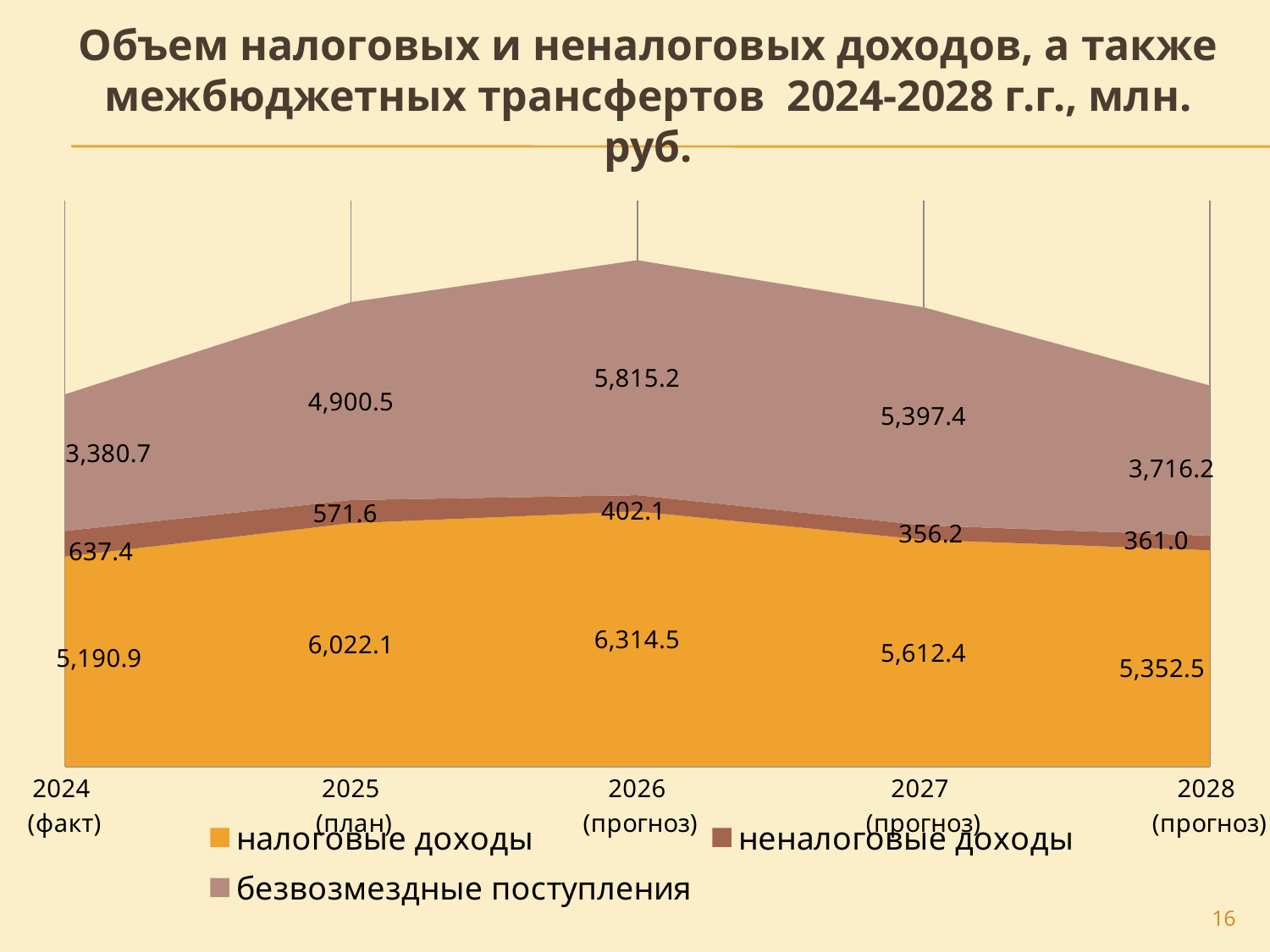
What is the value of безвозмездные поступления for 2024 (факт)? 3,380.7 What type of chart is shown on the slide? Stacked area chart In which year are налоговые доходы highest? 2026 (прогноз) In which year are неналоговые доходы lowest? 2027 (прогноз) How many years (categories) are plotted along the x axis? 5 Do неналоговые доходы rise or fall from 2024 to 2027? Fall What is the value of налоговые доходы for 2026 (прогноз)? 6,314.5 What is the total of all three series for 2026 (прогноз)? 12,531.8 Which is larger: безвозмездные поступления in 2025 (план) or in 2028 (прогноз)? 2025 (план) What is the value of неналоговые доходы for 2027 (прогноз)? 356.2 What is the difference between налоговые доходы in 2026 (прогноз) and 2024 (факт)? 1,123.6 How many series does the legend list? 3